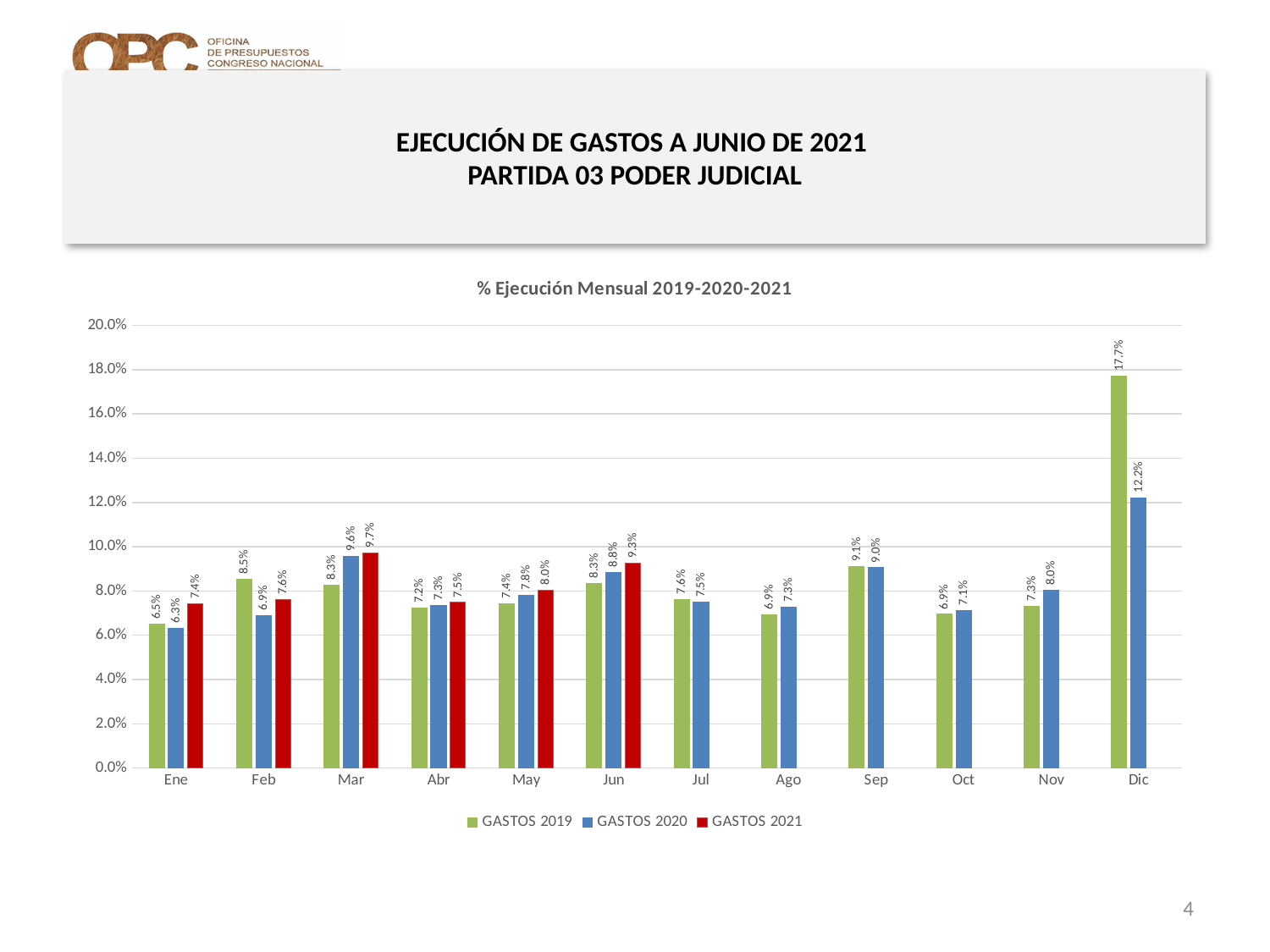
Which month has the lowest value for GASTOS 2019? Ene What is the title of the chart? % Ejecución Mensual 2019-2020-2021 How many months are shown on the x axis? 12 What is the value for GASTOS 2019 in Dic? 17.7% What kind of chart is shown on the slide? Bar chart What is the value for GASTOS 2021 in Mar? 9.7% What is the value for GASTOS 2020 in Jun? 8.8% Is the value for GASTOS 2019 in Dic greater or less than 16.0%? greater How many series does the legend list? 3 What is the difference between GASTOS 2019 and GASTOS 2020 in Dic? 5.5% Which is larger in Feb: GASTOS 2019 or GASTOS 2021? GASTOS 2019 Which month has the highest value for GASTOS 2020? Dic